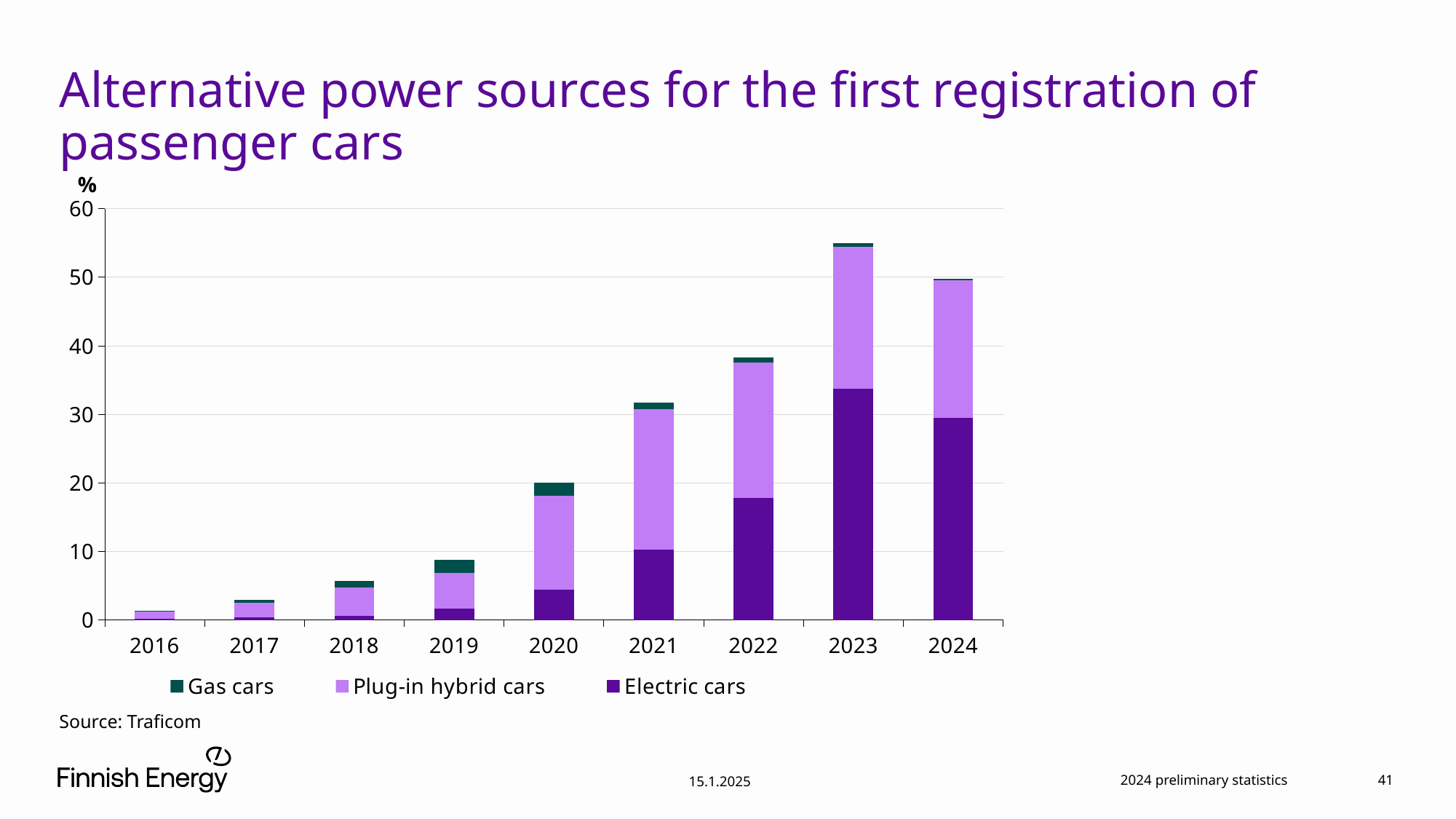
What unit is shown on the y axis? % Which year has the highest total share of alternative power sources? 2023 Is the value for Electric cars in 2023 greater or less than 30? greater What kind of chart is shown on the slide? Stacked bar chart In 2021, which is larger: the Plug-in hybrid cars share or the Electric cars share? Plug-in hybrid cars How many years are shown on the x axis? 9 Which year has the lowest total share of alternative power sources? 2016 Is the total stacked value for 2022 greater or less than 40? less Is the total stacked value for 2023 greater or less than 50? greater How many series does the legend list? 3 Which year has the larger Electric cars share, 2023 or 2024? 2023 Does the total share of alternative power sources rise or fall from 2016 to 2023? Rise